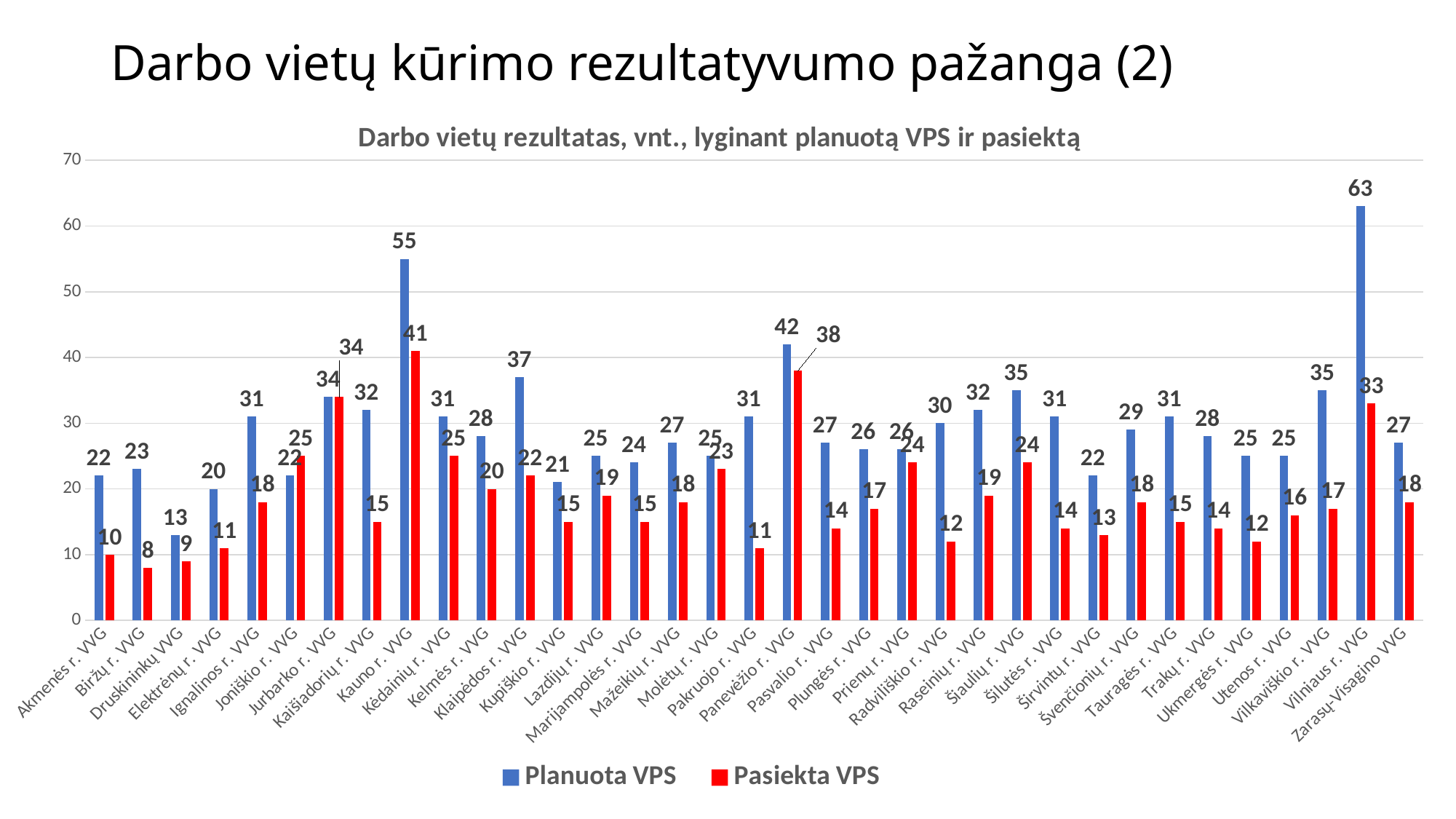
Is the Planuota VPS value for Klaipėdos r. VVG greater or less than 30? greater What is the title of the chart? Darbo vietų rezultatas, vnt., lyginant planuotą VPS ir pasiektą What is the difference between the Planuota VPS and Pasiekta VPS values for Vilniaus r. VVG? 30 How many series does the legend list? 2 Which category has the lowest Pasiekta VPS value? Biržų r. VVG What kind of chart is shown on the slide? bar chart What is the Planuota VPS value for Kauno r. VVG? 55 Which category has the lowest Planuota VPS value? Druskininkų VVG Which category has the highest Planuota VPS value? Vilniaus r. VVG How many categories are shown on the x axis? 35 Which is larger for Joniškio r. VVG: Planuota VPS or Pasiekta VPS? Pasiekta VPS What is the Pasiekta VPS value for Panevėžio r. VVG? 38